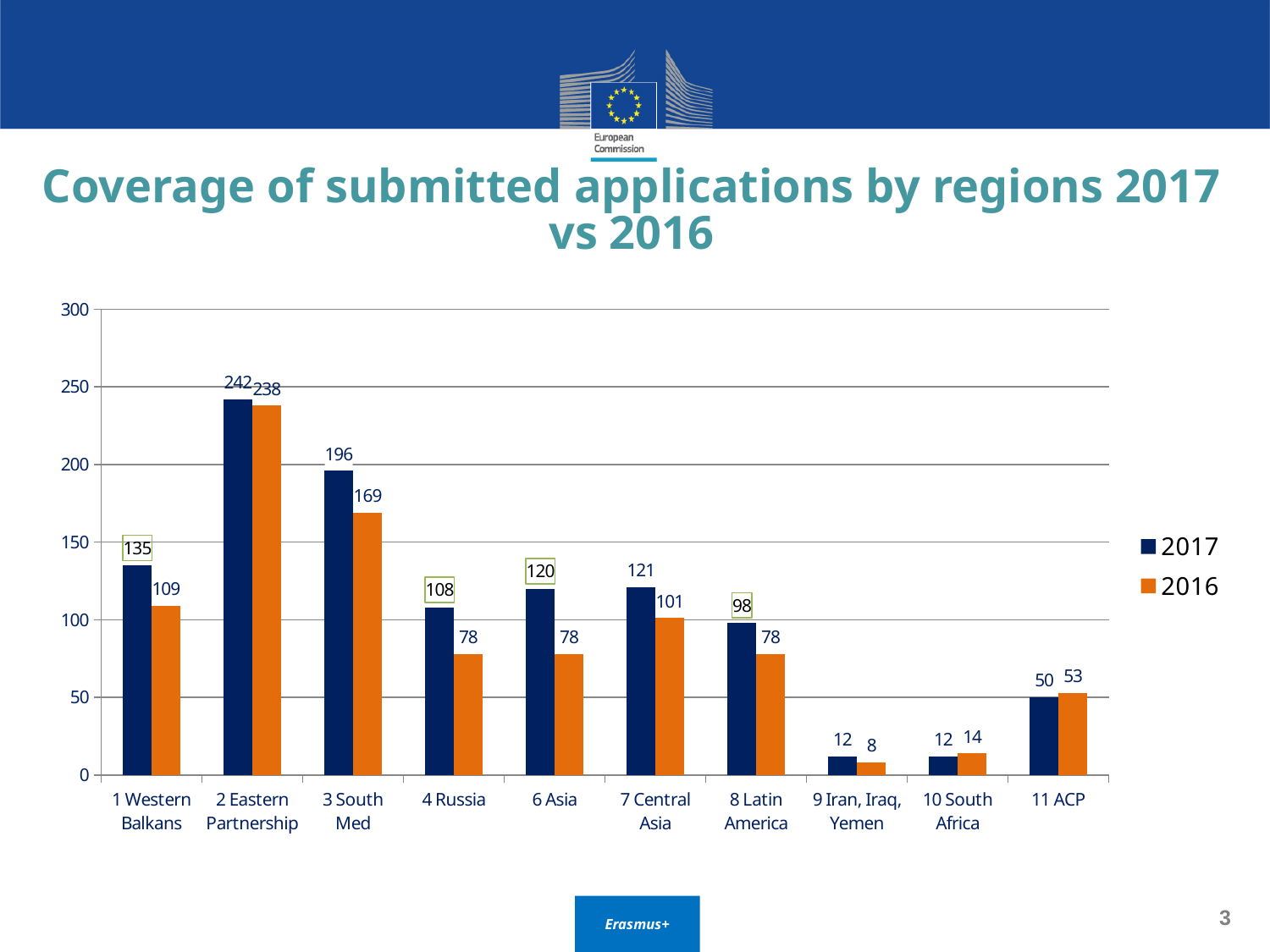
How many series does the legend list? 2 What is the 2017 value for 3 South Med? 196 What is the difference between the 2017 and 2016 values for 1 Western Balkans? 26 What kind of chart is shown on the slide? Bar chart What is the 2016 value for 7 Central Asia? 101 Which is larger, the 2017 value for 4 Russia or the 2017 value for 6 Asia? 6 Asia What is the difference between the 2017 and 2016 values for 3 South Med? 27 How many regions are shown on the x axis? 10 For 11 ACP, which is larger, the 2017 value or the 2016 value? 2016 Which region has the highest 2017 value? 2 Eastern Partnership Which region has the lowest 2016 value? 9 Iran, Iraq, Yemen What is the 2017 value for 9 Iran, Iraq, Yemen? 12